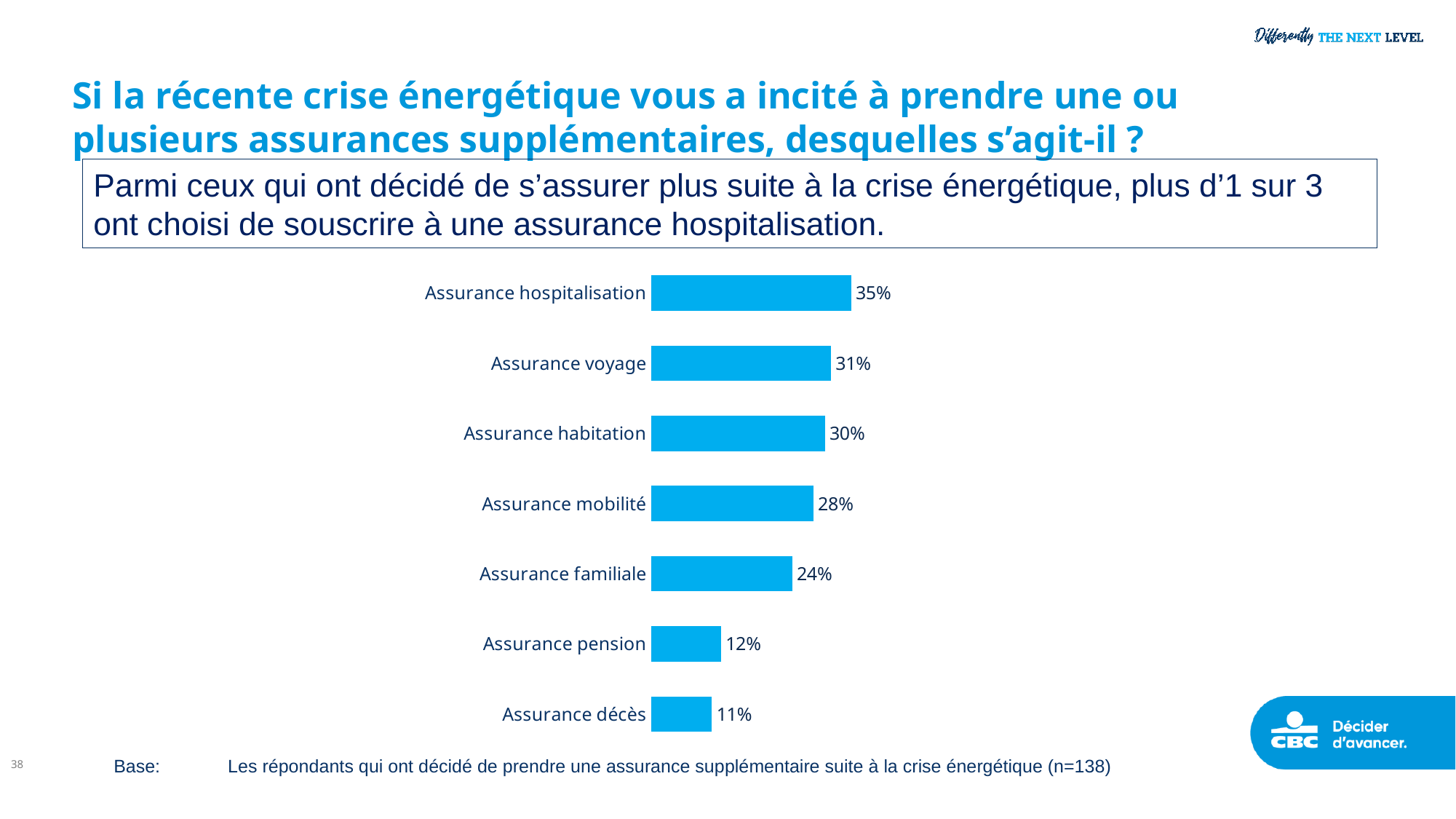
What is the value for Assurance familiale? 24% What is the value for Assurance hospitalisation? 35% What is the value for Assurance mobilité? 28% What is the value for Assurance décès? 11% Which category has the highest value? Assurance hospitalisation What is the difference between Assurance hospitalisation and Assurance voyage? 4% Which category has the lowest value? Assurance décès Which is larger, Assurance pension or Assurance habitation? Assurance habitation What is the difference between Assurance familiale and Assurance pension? 12% What kind of chart is shown on the slide? Bar chart How many categories are shown in the chart? 7 Which is larger, Assurance mobilité or Assurance familiale? Assurance mobilité